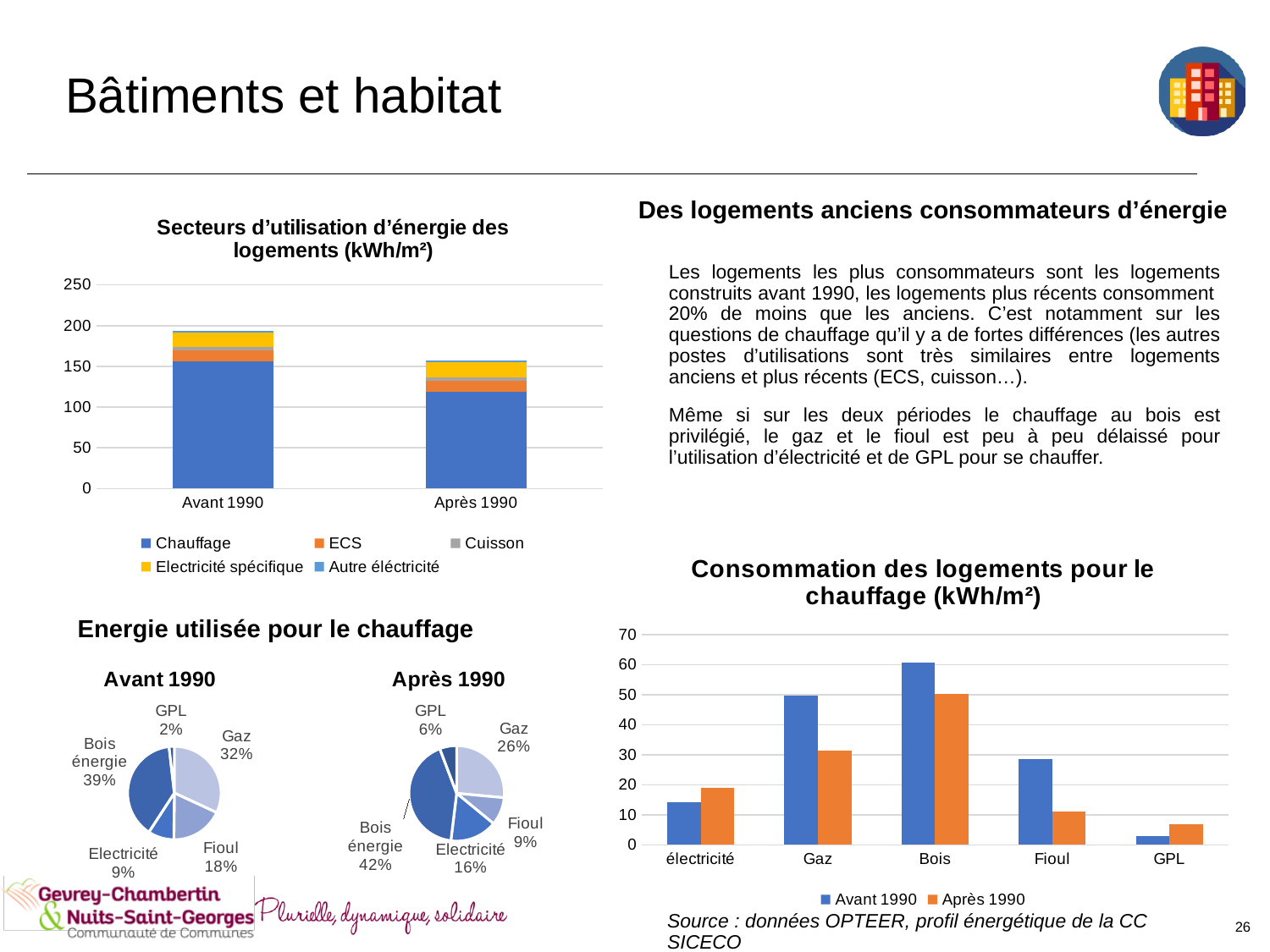
What kind of chart is 'Secteurs d'utilisation d'énergie des logements (kWh/m²)'? Stacked bar chart In the chart 'Consommation des logements pour le chauffage (kWh/m²)', which is larger for Gaz: Avant 1990 or Après 1990? Avant 1990 In the pie chart for Après 1990, which energy source has the largest share? Bois énergie In the pie chart for Avant 1990, which energy source has the smallest share? GPL In the chart 'Consommation des logements pour le chauffage (kWh/m²)', how many categories are shown on the x axis? 5 In the chart 'Consommation des logements pour le chauffage (kWh/m²)', which category has the highest value for Avant 1990? Bois In the pie chart for Après 1990 under 'Energie utilisée pour le chauffage', what share does Gaz have? 26% In the pie chart for Avant 1990 under 'Energie utilisée pour le chauffage', what share does Bois énergie have? 39% In the chart 'Consommation des logements pour le chauffage (kWh/m²)', is the Avant 1990 value for Fioul greater or less than 30? less What is the difference between the Fioul share in the Avant 1990 pie chart and the Fioul share in the Après 1990 pie chart? 9% Which is larger: the Electricité share in the Avant 1990 pie chart or in the Après 1990 pie chart? Après 1990 How many series does the legend of the chart 'Secteurs d'utilisation d'énergie des logements (kWh/m²)' list? 5